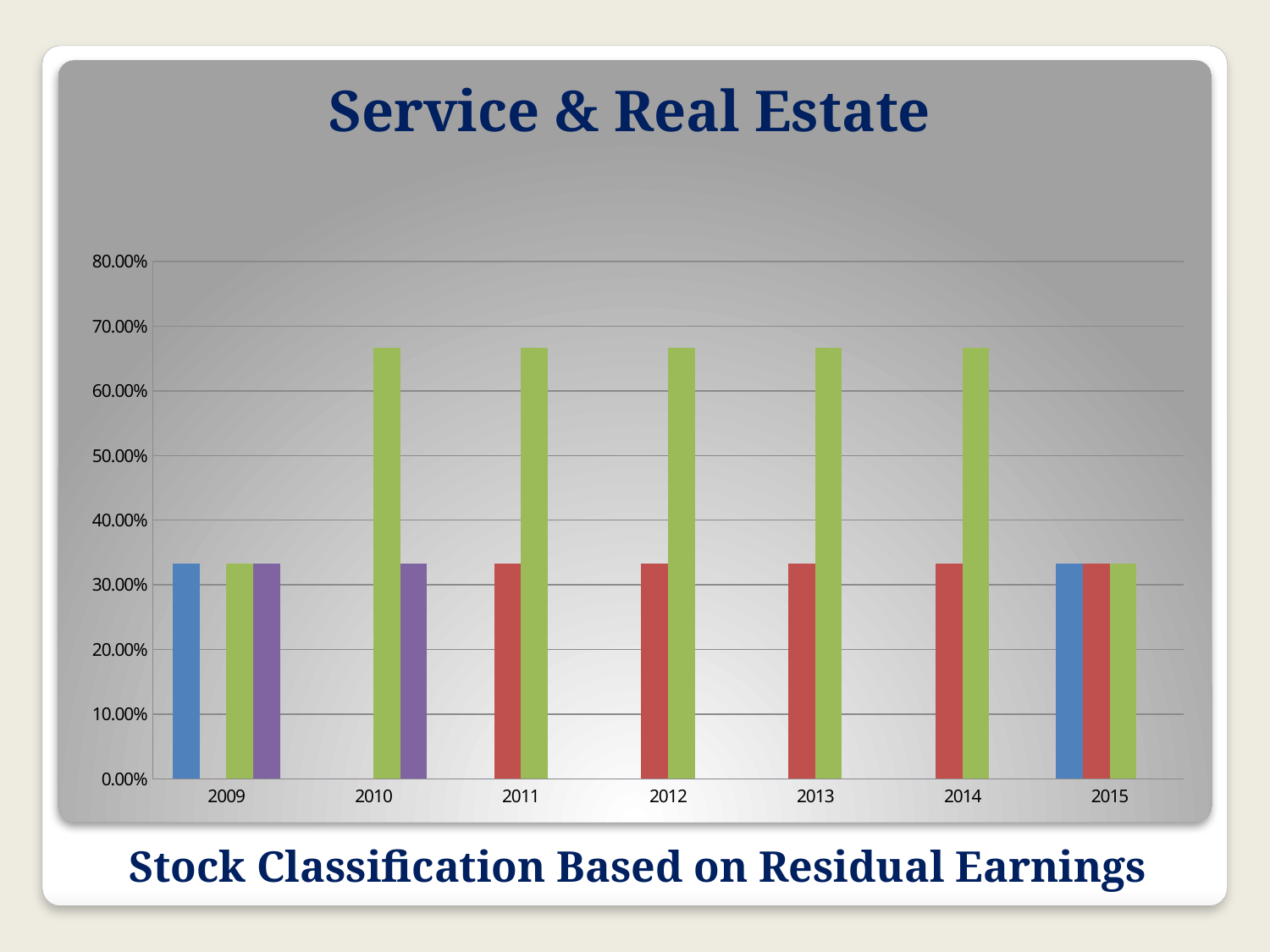
Is the value of the red bar for 2011 greater or less than 40%? less What kind of chart is shown on the slide? bar chart In 2012, which bar is taller, the green bar or the red bar? the green bar What is the highest value shown on the y axis? 80.00% Is the value of the green bar for 2015 greater or less than 50%? less How many years are shown on the x axis of the chart? 7 How many bars are plotted for 2015? 3 Is the value of the blue bar for 2009 greater or less than 30%? greater What is the title of the chart? Service & Real Estate Does the green bar rise, fall, or stay the same from 2010 to 2014? stays the same